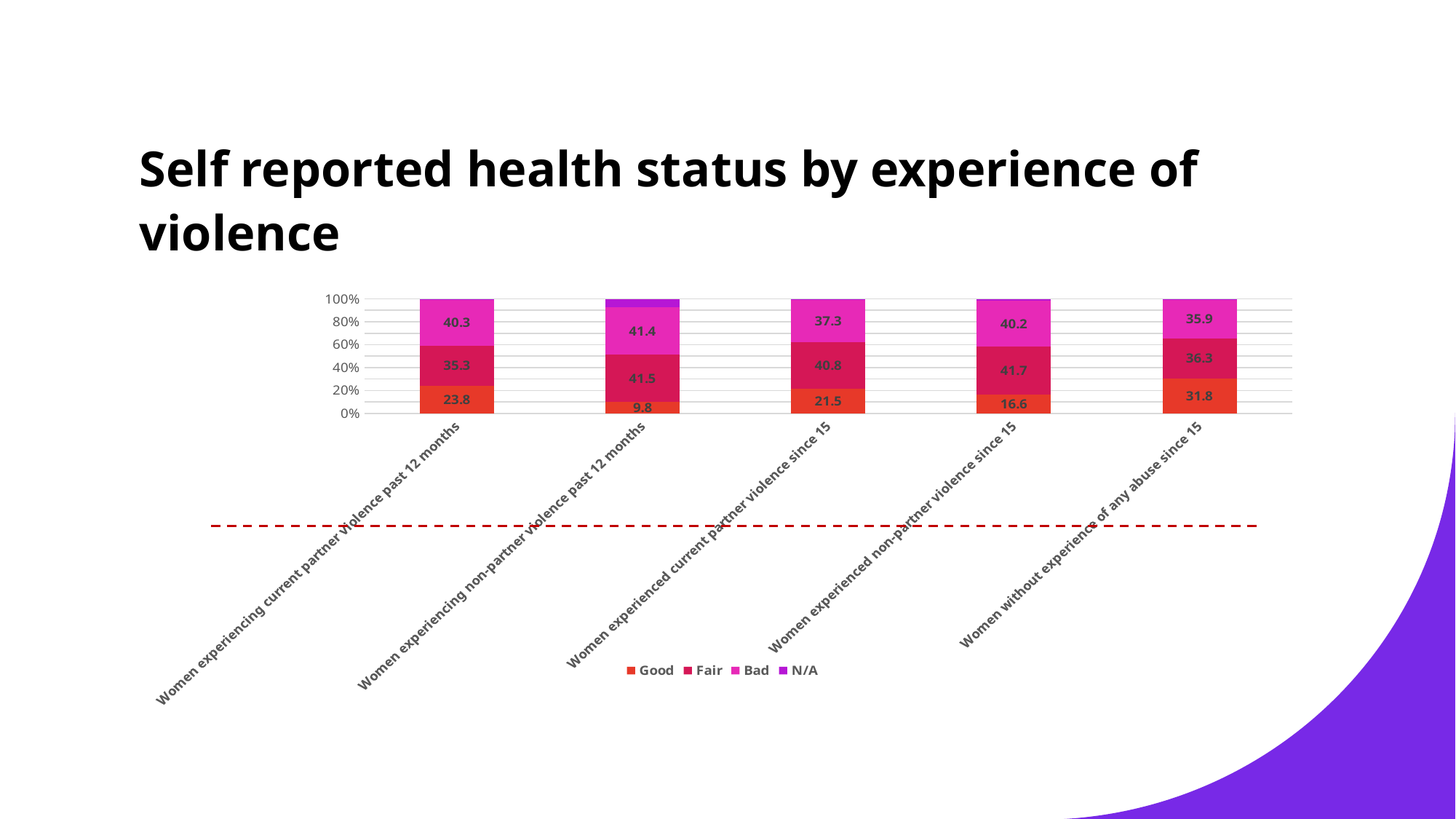
How many series does the legend list? 4 What is the difference between the Good value for Women without experience of any abuse since 15 and the Good value for Women experiencing non-partner violence past 12 months? 22.0 What is the Fair value for Women experienced non-partner violence since 15? 41.7 Which category has the lowest Good value? Women experiencing non-partner violence past 12 months What is the Good value for Women experiencing current partner violence past 12 months? 23.8 How many categories are shown on the x axis? 5 What kind of chart is shown on the slide? Stacked bar chart What is the Good value for Women without experience of any abuse since 15? 31.8 Which is larger: the Bad value for Women experiencing current partner violence past 12 months or the Bad value for Women without experience of any abuse since 15? Women experiencing current partner violence past 12 months Which category has the highest Good value? Women without experience of any abuse since 15 Which category has the lowest Bad value? Women without experience of any abuse since 15 What is the Bad value for Women experienced current partner violence since 15? 37.3